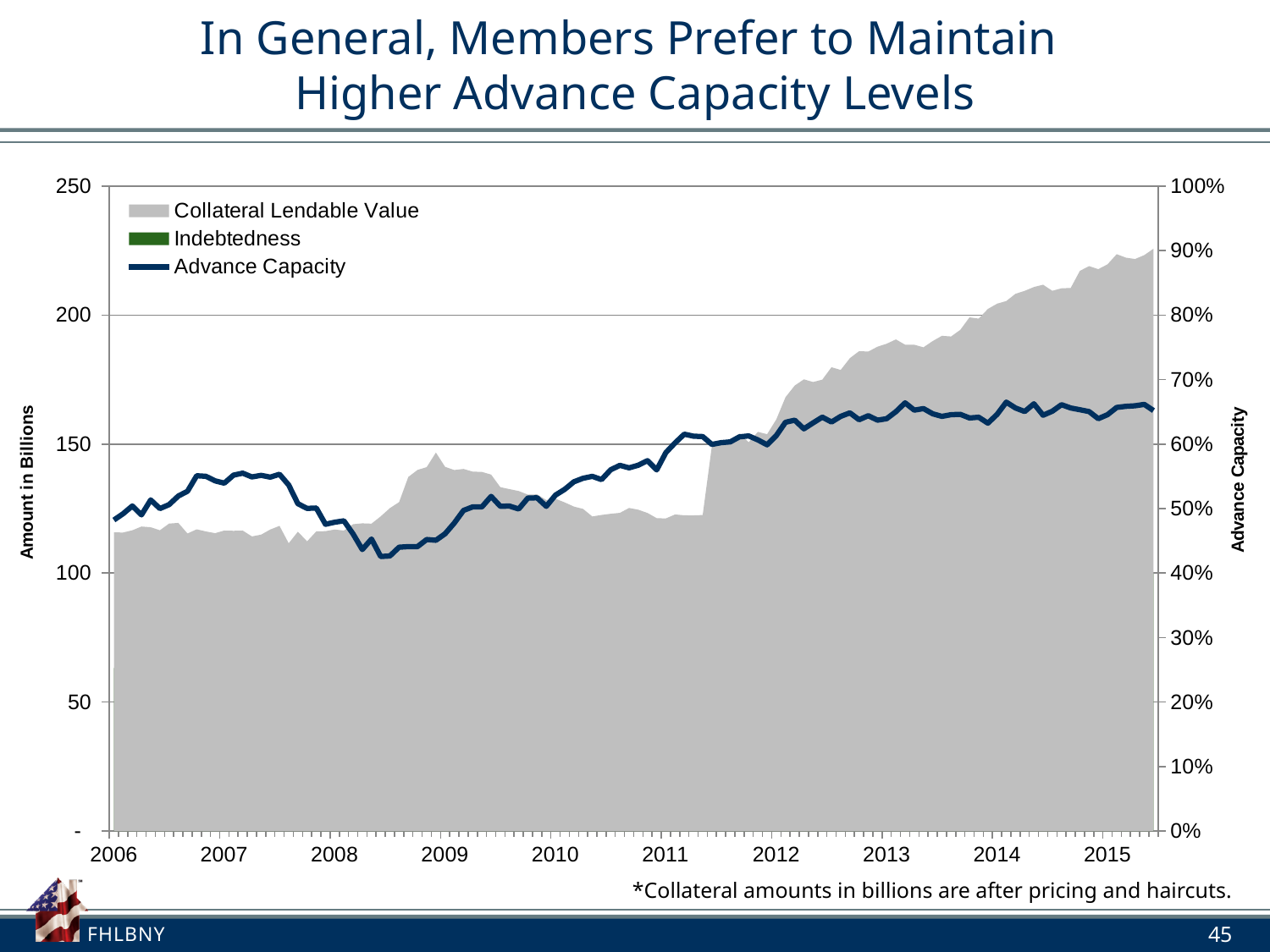
Is the Advance Capacity at the start of 2013 greater or less than 60%? greater How many year labels are shown on the x axis? 10 What is the title of the left vertical axis? Amount in Billions Is the Collateral Lendable Value at the end of 2015 greater or less than 200? greater Is the Advance Capacity in mid-2008 greater or less than 50%? less What are the three series named in the legend? Collateral Lendable Value, Indebtedness, Advance Capacity Is the Collateral Lendable Value higher at the end of 2015 or at the start of 2006? End of 2015 How many series does the legend list? 3 Does the Collateral Lendable Value rise or fall overall from 2006 to 2015? rise What kind of chart is shown on the slide? Area and line chart